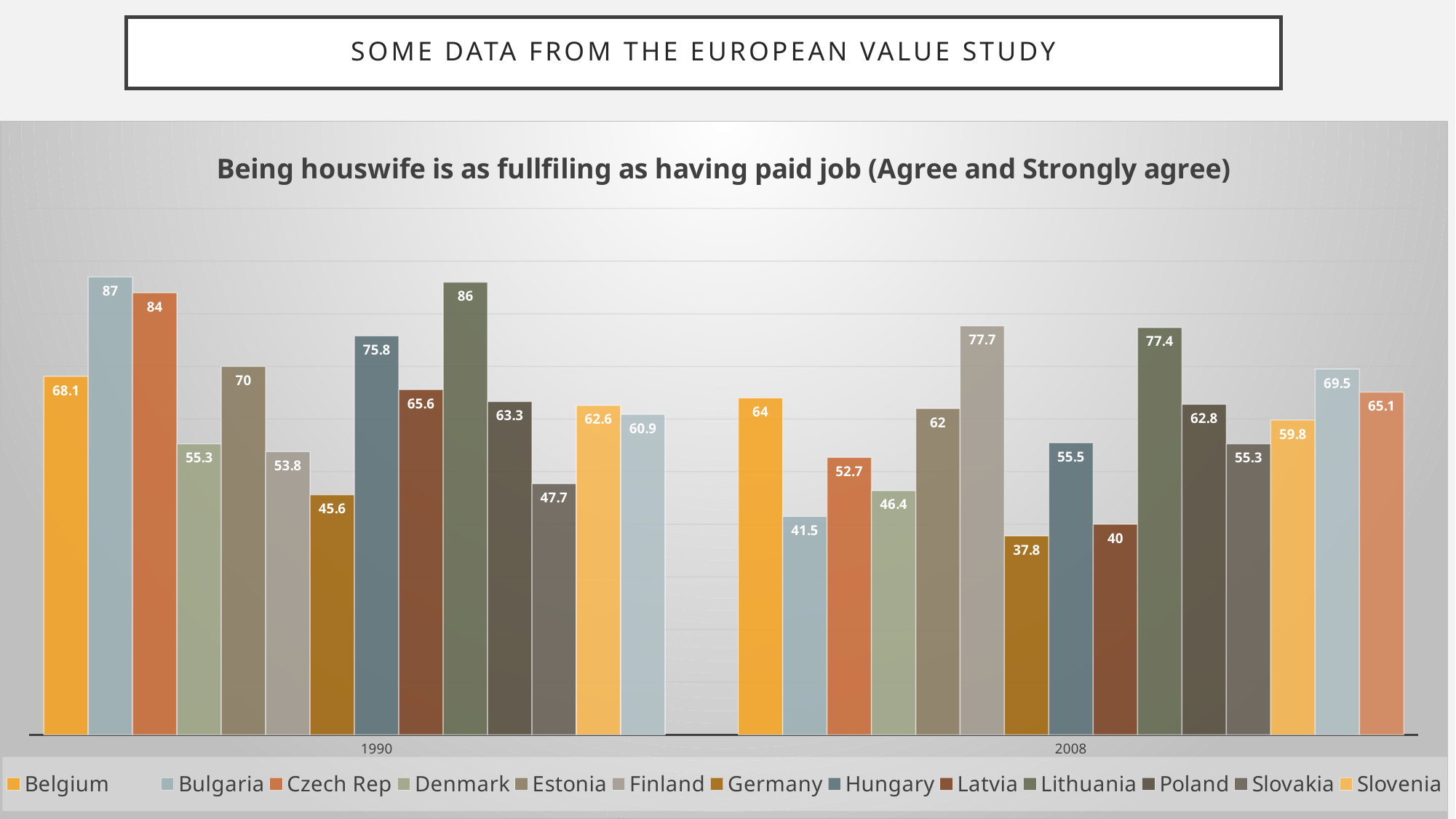
What is the value for Estonia in 2008? 62 Which country has the highest value in 1990? Bulgaria What kind of chart is shown on the slide? Bar chart Which country has the lowest value in 1990? Germany What is the value for Bulgaria in 1990? 87 What is the value for Germany in 2008? 37.8 What is the value for Hungary in 1990? 75.8 How many years are shown on the x axis? 2 Is Hungary's value larger in 1990 or in 2008? 1990 What is the difference between Bulgaria's value in 1990 and in 2008? 45.5 How many countries does the legend list? 13 Which country has the highest value in 2008? Finland